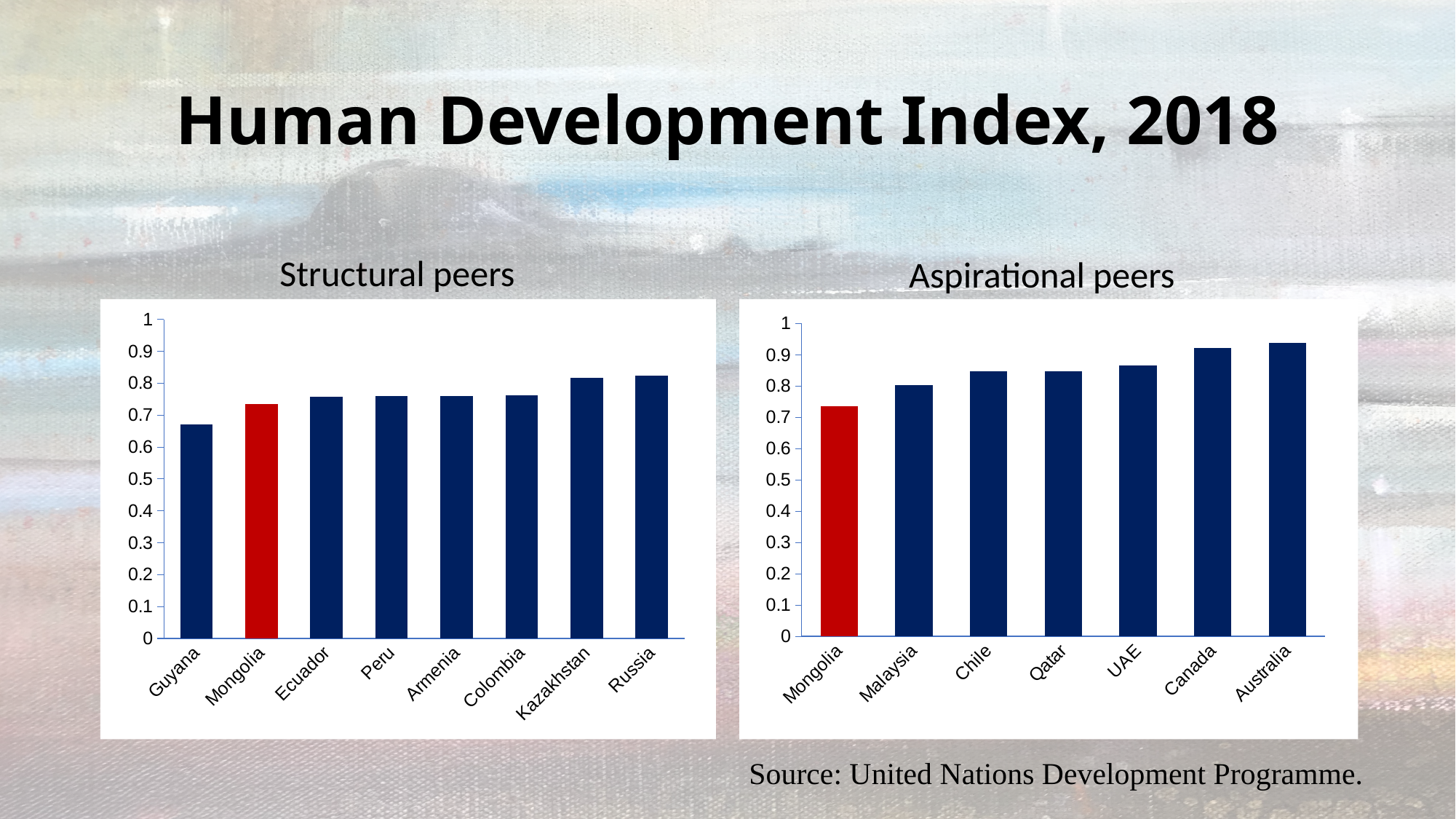
In the Structural peers chart, is the value for Russia greater or less than 0.8? greater How many countries are shown in the Aspirational peers chart? 7 In the Aspirational peers chart, which is larger, the value for Mongolia or the value for Malaysia? Malaysia In the Aspirational peers chart, is the value for Canada greater or less than 0.9? greater In the Structural peers chart, is the value for Guyana greater or less than 0.7? less In the Aspirational peers chart, which country has the highest Human Development Index? Australia In the Structural peers chart, which country's bar is coloured red? Mongolia In the Aspirational peers chart, which country has the lowest Human Development Index? Mongolia What kind of chart is the Structural peers chart? bar chart In the Structural peers chart, which country has the lowest Human Development Index? Guyana How many countries are shown in the Structural peers chart? 8